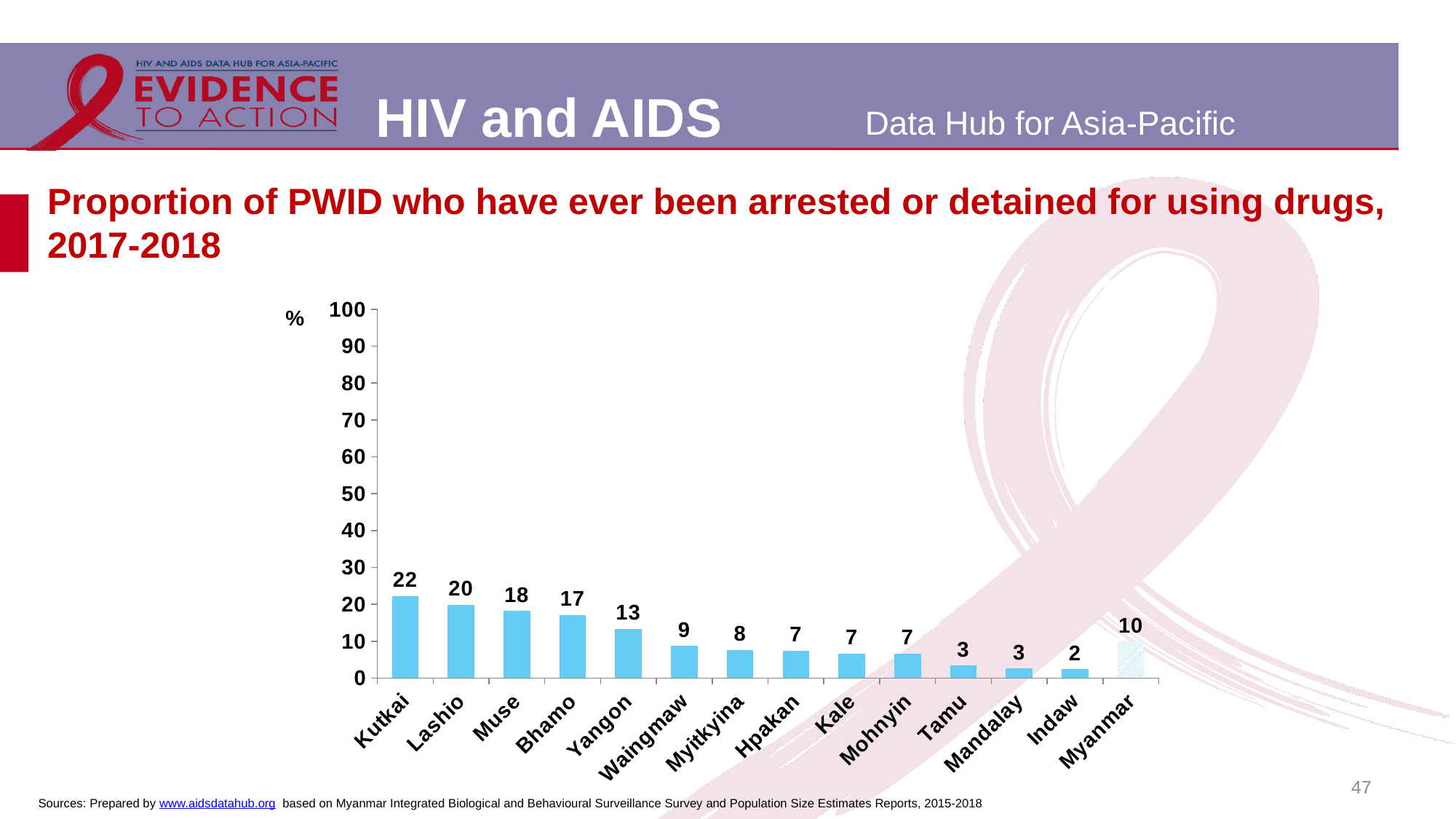
What unit is shown on the y axis of the chart? % What kind of chart is shown on the slide? bar chart What is the value for Myanmar? 10 Is the value for Lashio greater or less than 30? less What is the difference between the values for Kutkai and Lashio? 2 How many categories are shown on the x axis? 14 Which is larger, the value for Bhamo or the value for Waingmaw? Bhamo What is the difference between the values for Muse and Indaw? 16 Which site has the highest proportion of PWID ever arrested or detained? Kutkai Which site has the lowest value on the chart? Indaw What is the value for Kutkai? 22 What is the value for Yangon? 13